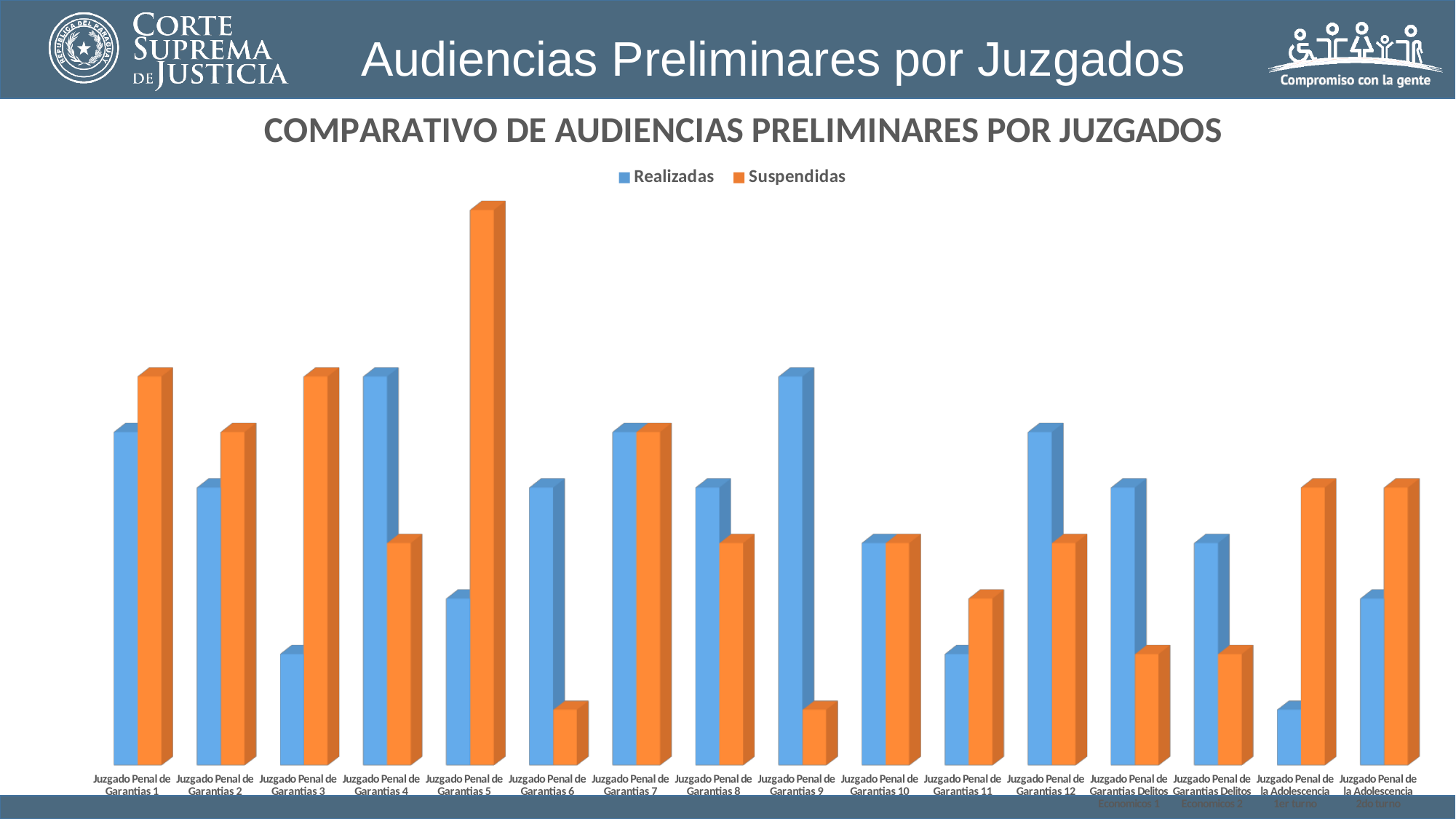
For Juzgado Penal de Garantias 3, which is larger: Realizadas or Suspendidas? Suspendidas How many series does the legend list? 2 What kind of chart is shown on the slide? bar chart For Juzgado Penal de Garantias 12, which is larger: Realizadas or Suspendidas? Realizadas Which colour represents the Suspendidas series in the legend? orange Which has the larger Realizadas value: Juzgado Penal de Garantias 2 or Juzgado Penal de Garantias 3? Juzgado Penal de Garantias 2 Which juzgado has the highest Suspendidas value? Juzgado Penal de Garantias 5 How many juzgados (categories) are shown on the x axis? 16 What is the title of the chart? COMPARATIVO DE AUDIENCIAS PRELIMINARES POR JUZGADOS